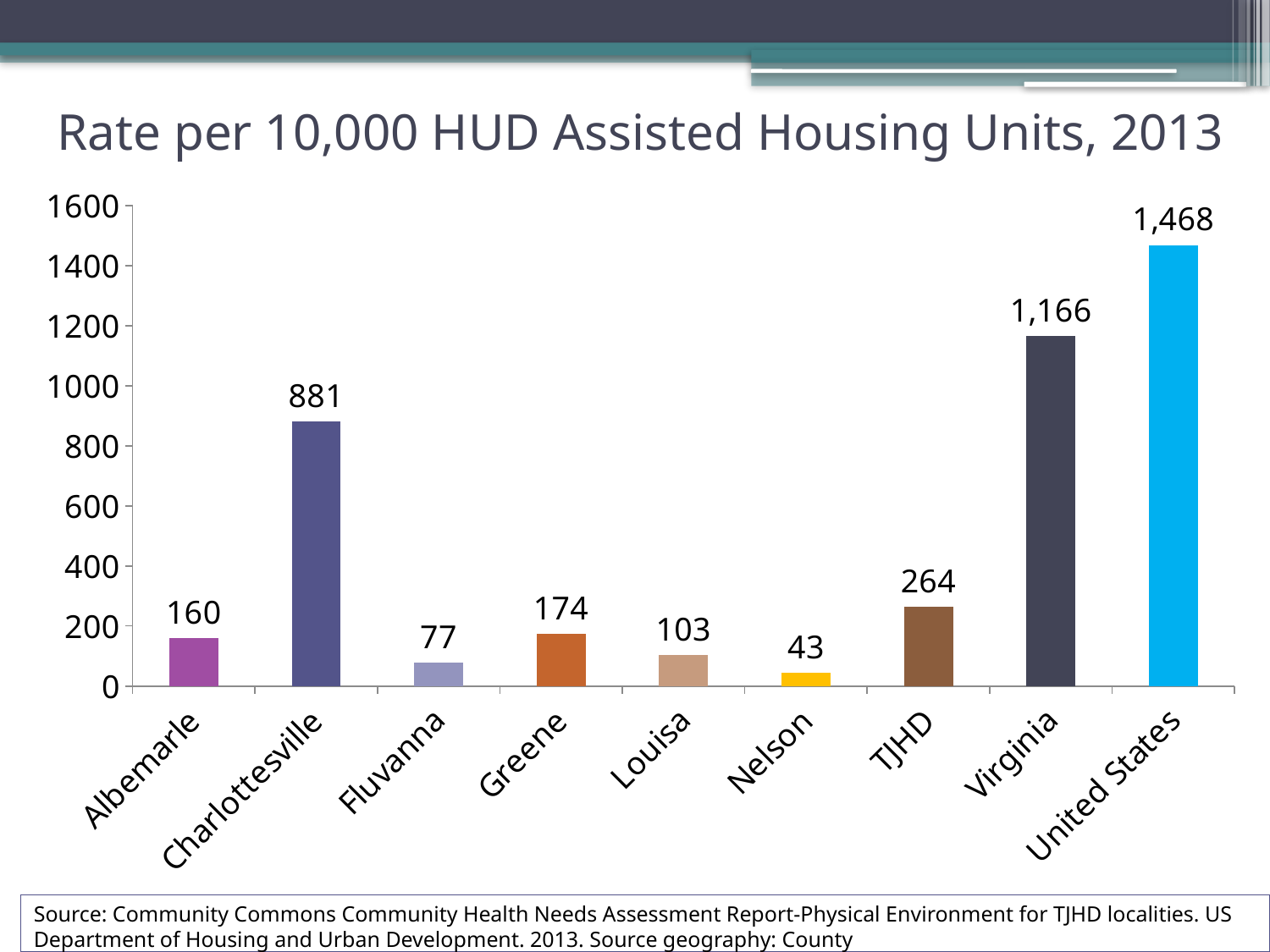
What is the title of the chart? Rate per 10,000 HUD Assisted Housing Units, 2013 What is the difference between the values for United States and Virginia? 302 Which category has the lowest value? Nelson What is the value shown for Virginia? 1,166 What is the value shown for Nelson? 43 What kind of chart is shown on the slide? Bar chart What is the difference between the values for Greene and Albemarle? 14 Is the value for Charlottesville greater or less than 800? greater Which category has the highest value? United States What is the rate per 10,000 HUD assisted housing units for Charlottesville? 881 Which is larger, the value for TJHD or the value for Louisa? TJHD How many categories are shown on the x axis? 9